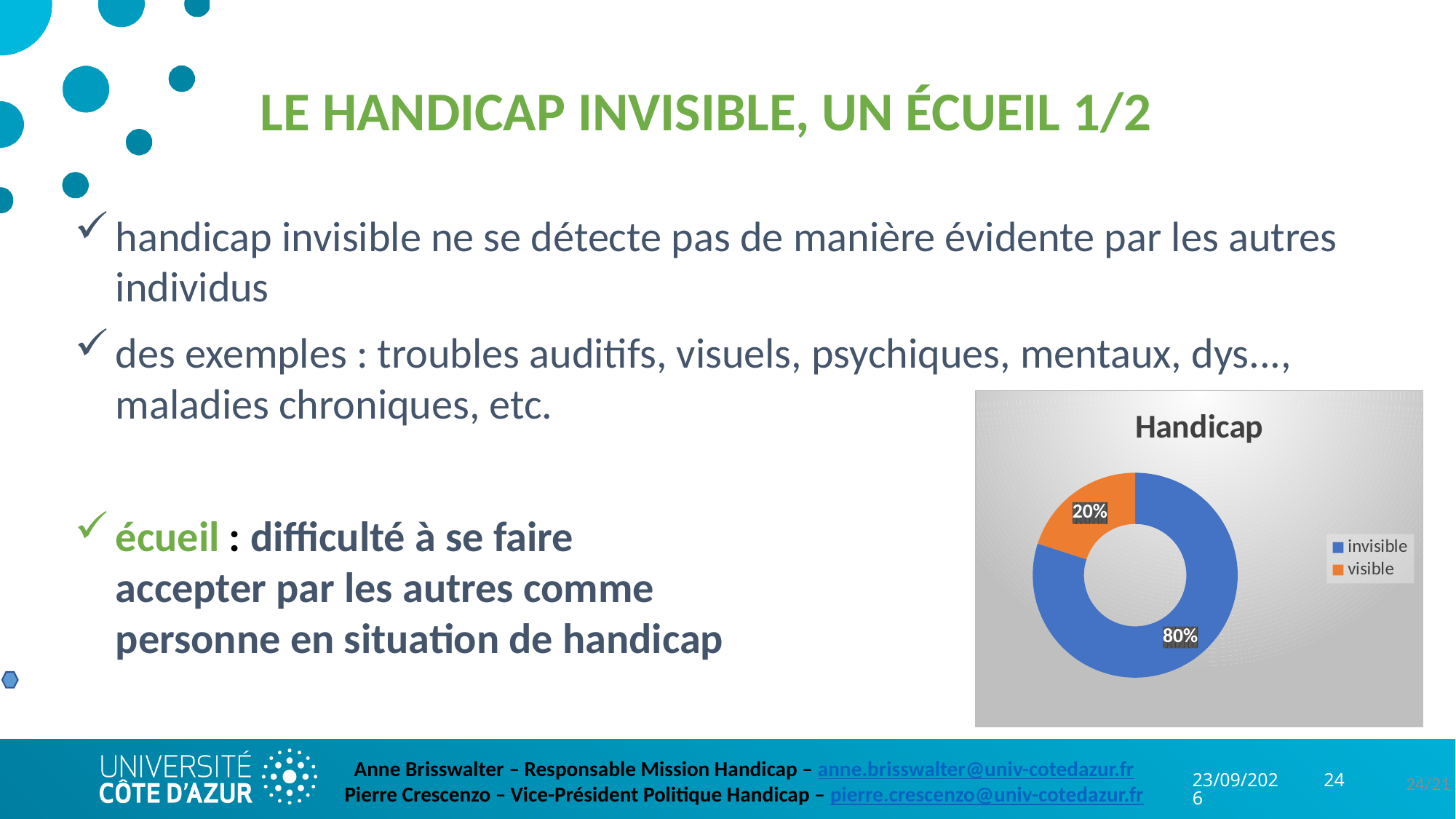
How many entries does the chart legend list? 2 How many categories does the chart show? 2 What is the title of the chart on the slide? Handicap What is the difference in percentage points between "invisible" and "visible"? 60 What percentage does the chart show for "visible"? 20% What percentage does the chart show for "invisible"? 80% Which category has the smallest share in the chart? visible Which is larger, the share for "invisible" or the share for "visible"? invisible What kind of chart is shown on the slide? Doughnut (pie) chart What share of the chart does the "invisible" slice represent? 80% What colour represents "visible" in the chart? Orange Which category has the largest share in the chart? invisible